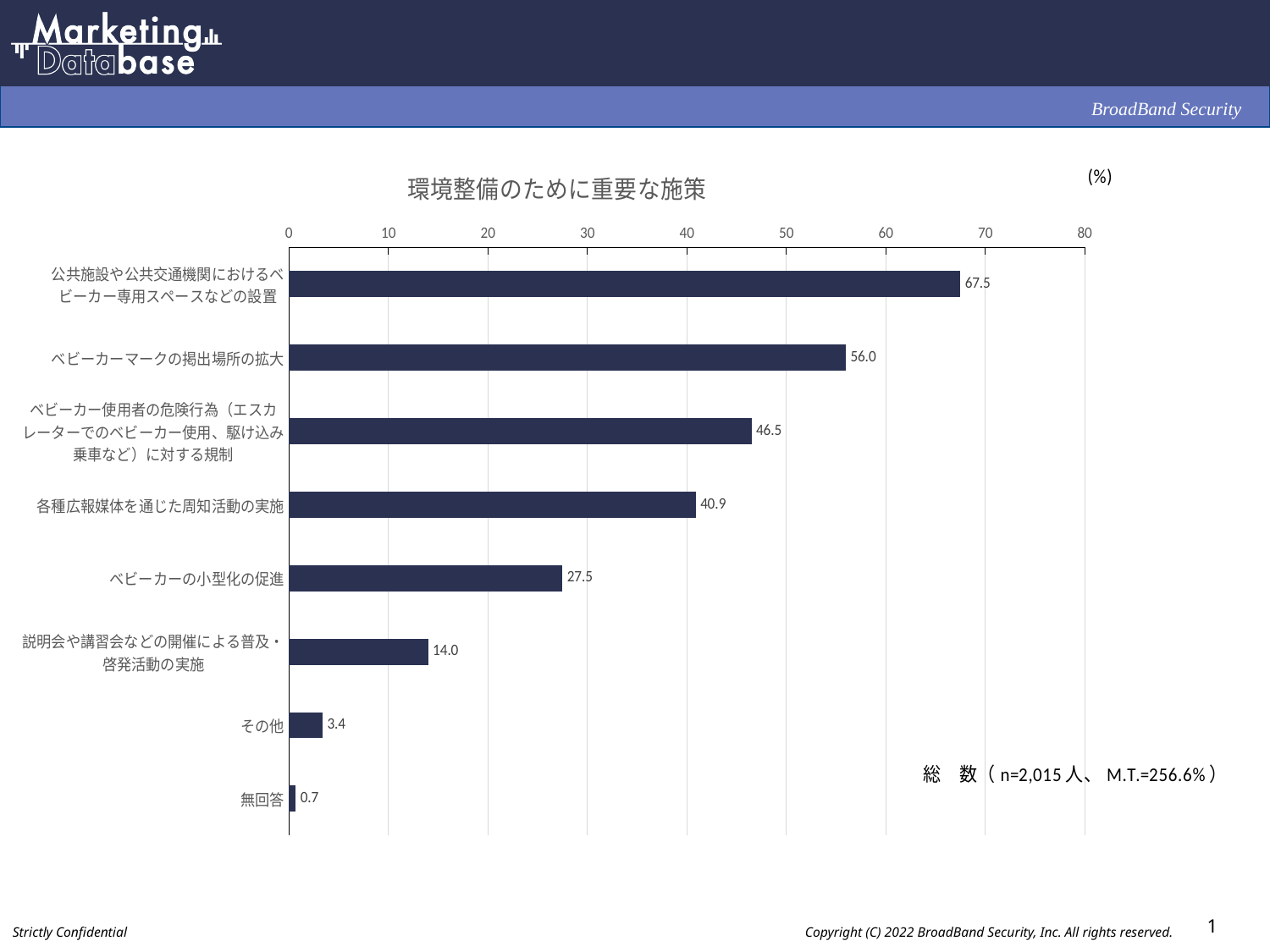
Which is larger, the value for 各種広報媒体を通じた周知活動の実施 or the value for ベビーカーの小型化の促進? 各種広報媒体を通じた周知活動の実施 Which category has the highest value? 公共施設や公共交通機関におけるベビーカー専用スペースなどの設置 What is the title of the chart? 環境整備のために重要な施策 Is the value for ベビーカー使用者の危険行為（エスカレーターでのベビーカー使用、駆け込み乗車など）に対する規制 greater or less than 40? greater What is the value for ベビーカーの小型化の促進? 27.5 What kind of chart is shown on the slide? bar chart What is the value for ベビーカーマークの掲出場所の拡大? 56.0 What is the value for その他? 3.4 What is the value for 各種広報媒体を通じた周知活動の実施? 40.9 Which category has the lowest value? 無回答 What is the difference between the values for 公共施設や公共交通機関におけるベビーカー専用スペースなどの設置 and ベビーカーマークの掲出場所の拡大? 11.5 How many categories are shown in the chart? 8